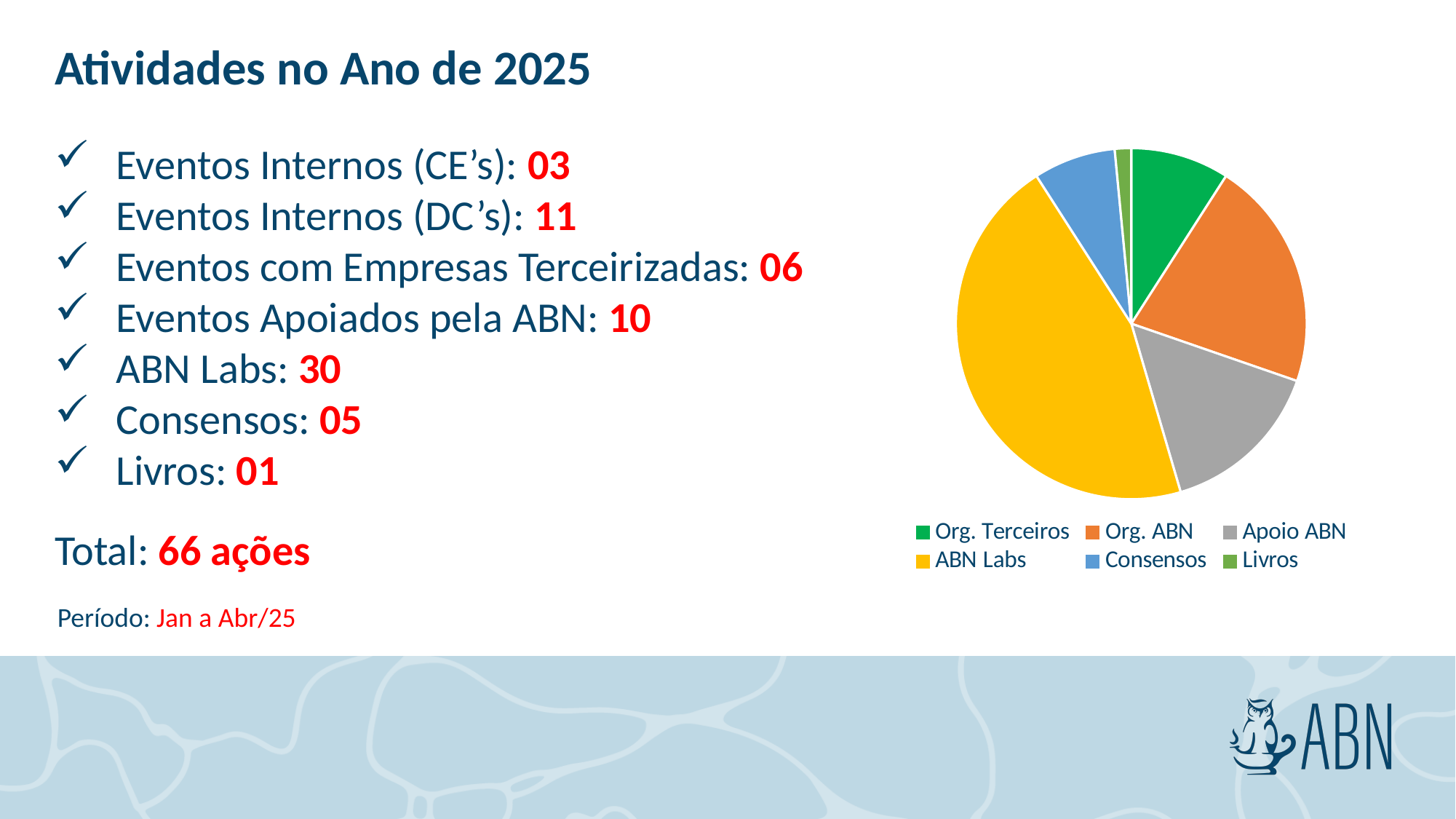
According to the slide, how many Livros were there? 01 According to the slide, how many ABN Labs activities were there? 30 Which slice is larger in the pie chart, ABN Labs or Apoio ABN? ABN Labs Which slice is larger in the pie chart, Org. ABN or Org. Terceiros? Org. ABN Which legend entry is shown in orange in the pie chart? Org. ABN Which category has the smallest slice in the pie chart? Livros According to the slide, how many Consensos were there? 05 What kind of chart is shown on the slide? pie chart Which category has the largest slice in the pie chart? ABN Labs What colour is the ABN Labs slice in the pie chart? yellow Which slice is larger in the pie chart, Apoio ABN or Consensos? Apoio ABN How many categories does the pie chart's legend list? 6